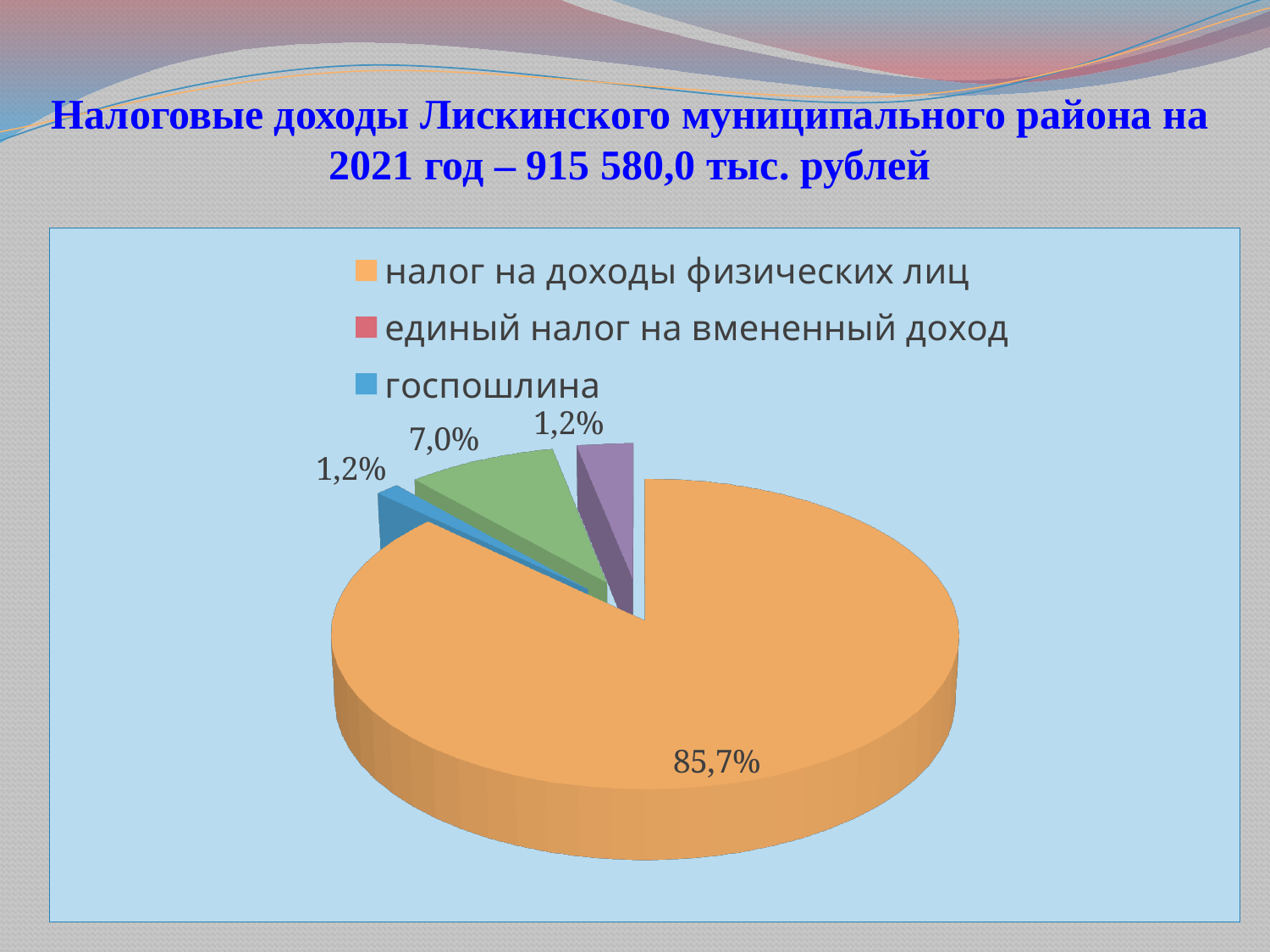
What share of the pie does госпошлина account for? 1,2% Is the share for налог на доходы физических лиц greater or less than 50%? greater What is the difference in percentage points between the 85,7% slice and the 7,0% slice? 78,7 Which is larger: the slice for налог на доходы физических лиц or the slice for госпошлина? налог на доходы физических лиц What share of the pie does налог на доходы физических лиц account for? 85,7% What colour is the slice for налог на доходы физических лиц? orange How many slices does the pie chart have? 4 Which legend category has the largest slice of the pie? налог на доходы физических лиц What percentage is labelled on the green slice of the pie? 7,0% What kind of chart is shown on the slide? pie chart What total amount of tax revenue for 2021 is stated in the slide title? 915 580,0 тыс. рублей How many entries does the legend list? 3